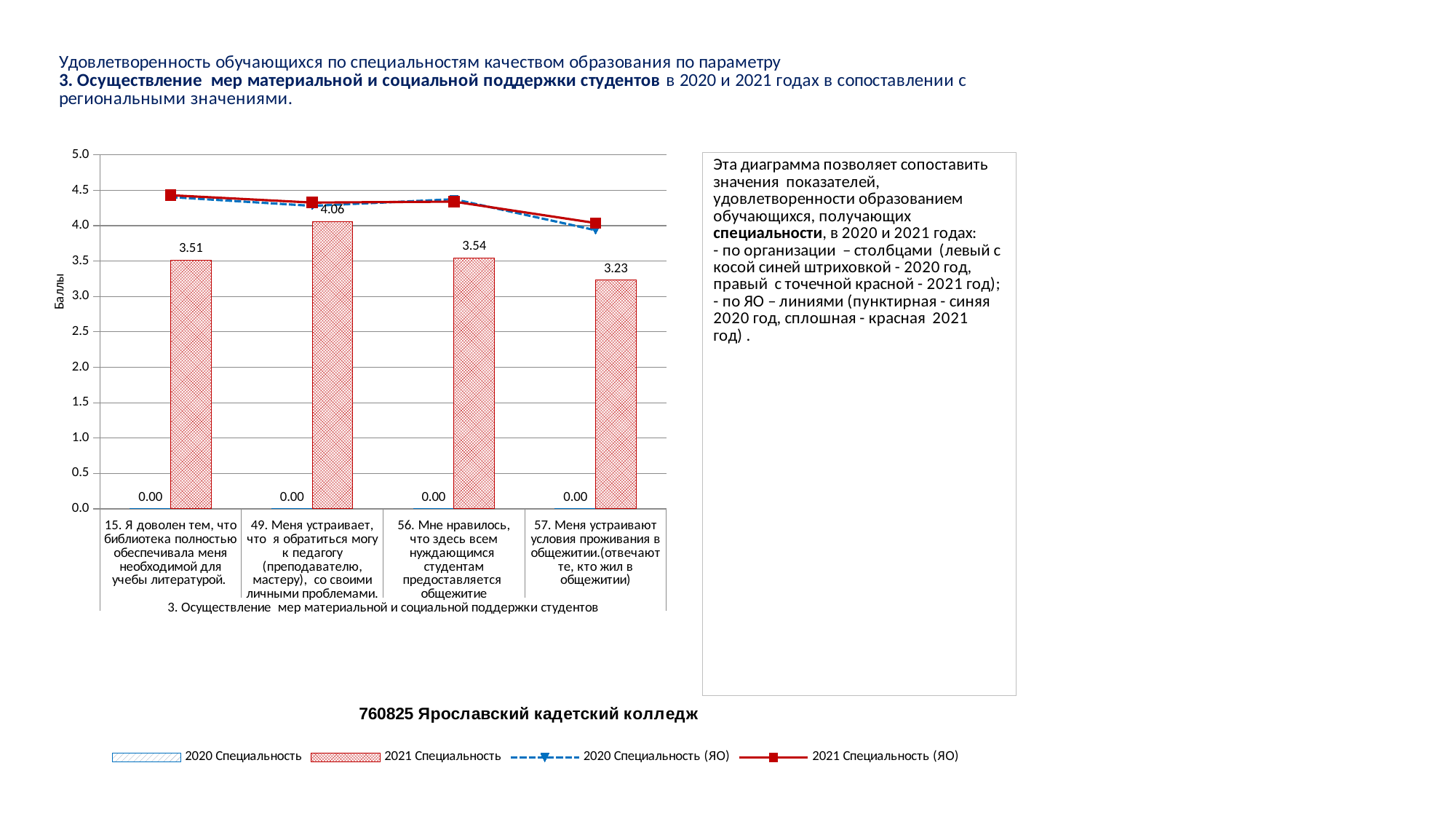
How many series does the legend list? 4 What is the 2020 Специальность value for question 15? 0.00 What is the 2021 Специальность value for question 49 (ability to approach a teacher with personal problems)? 4.06 What is the difference between the 2021 Специальность values for question 49 and question 57? 0.83 What is the 2021 Специальность value for question 15 (library provision)? 3.51 What is the label of the y axis? Баллы Which question has the lowest 2021 Специальность value? 57. Меня устраивают условия проживания в общежитии.(отвечают те, кто жил в общежитии) Which question has the highest 2021 Специальность value? 49. Меня устраивает, что я обратиться могу к педагогу (преподавателю, мастеру), со своими личными проблемами. How many questions (categories) are shown on the x axis? 4 Is the 2021 Специальность (ЯО) value for question 15 greater or less than 4.0? greater What is the 2021 Специальность value for question 56 (dormitory provided to all students in need)? 3.54 What is the 2021 Специальность value for question 57 (dormitory living conditions)? 3.23